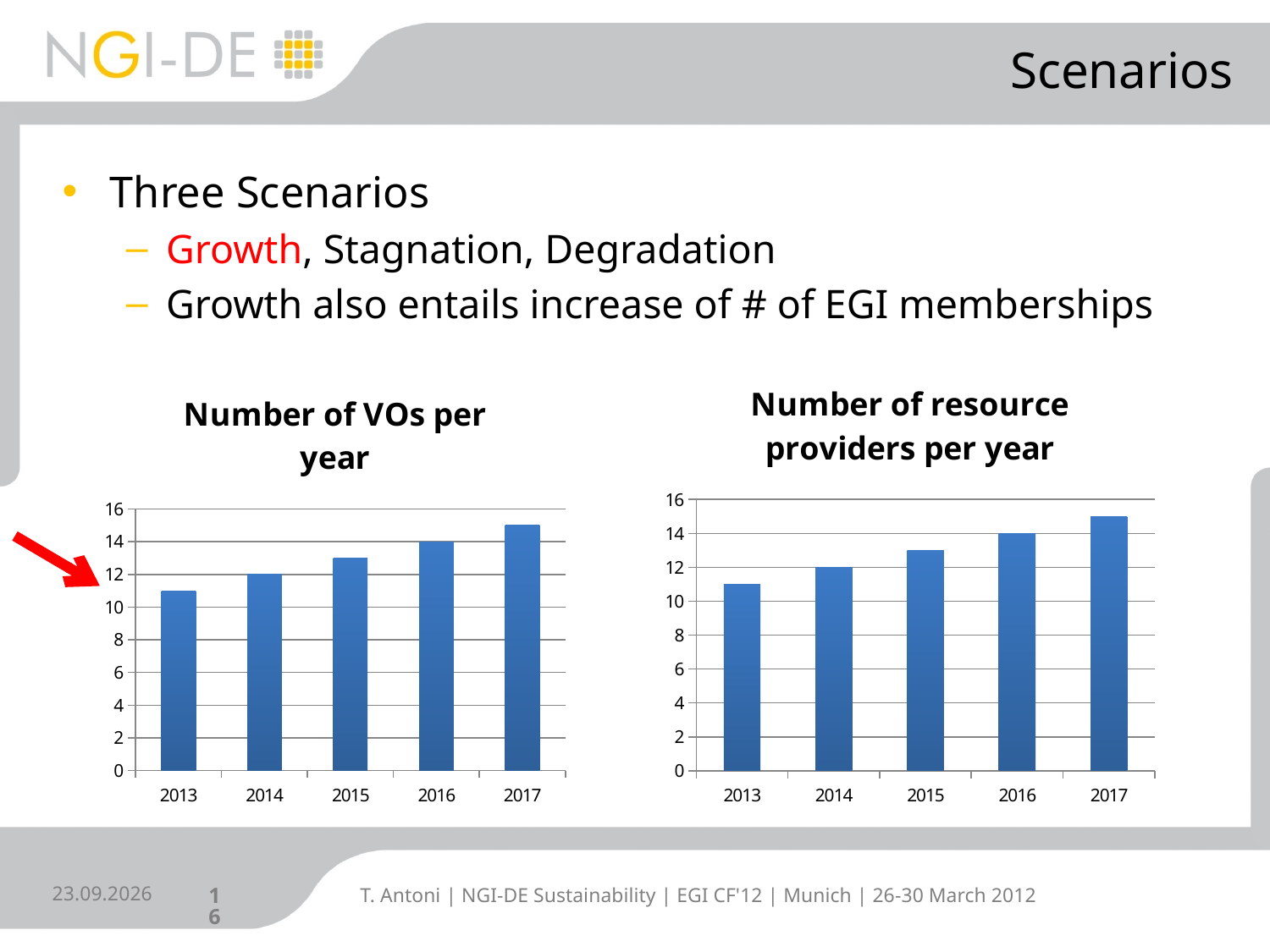
In the 'Number of VOs per year' chart, how many years are shown on the x axis? 5 What is the title of the chart on the right side of the slide? Number of resource providers per year In the 'Number of VOs per year' chart, which year has the highest value? 2017 In the 'Number of VOs per year' chart, do the values rise or fall from 2013 to 2017? rise In the 'Number of VOs per year' chart, is the value for 2013 greater or less than 12? less What kind of chart is the 'Number of VOs per year' chart? bar chart In the 'Number of resource providers per year' chart, what is the value for 2016? 14 In the 'Number of VOs per year' chart, what is the value for 2014? 12 In the 'Number of VOs per year' chart, what is the value for 2016? 14 In the 'Number of resource providers per year' chart, which is larger, the value for 2015 or the value for 2017? 2017 In the 'Number of resource providers per year' chart, is the value for 2017 greater or less than 14? greater In the 'Number of resource providers per year' chart, which year has the lowest value? 2013